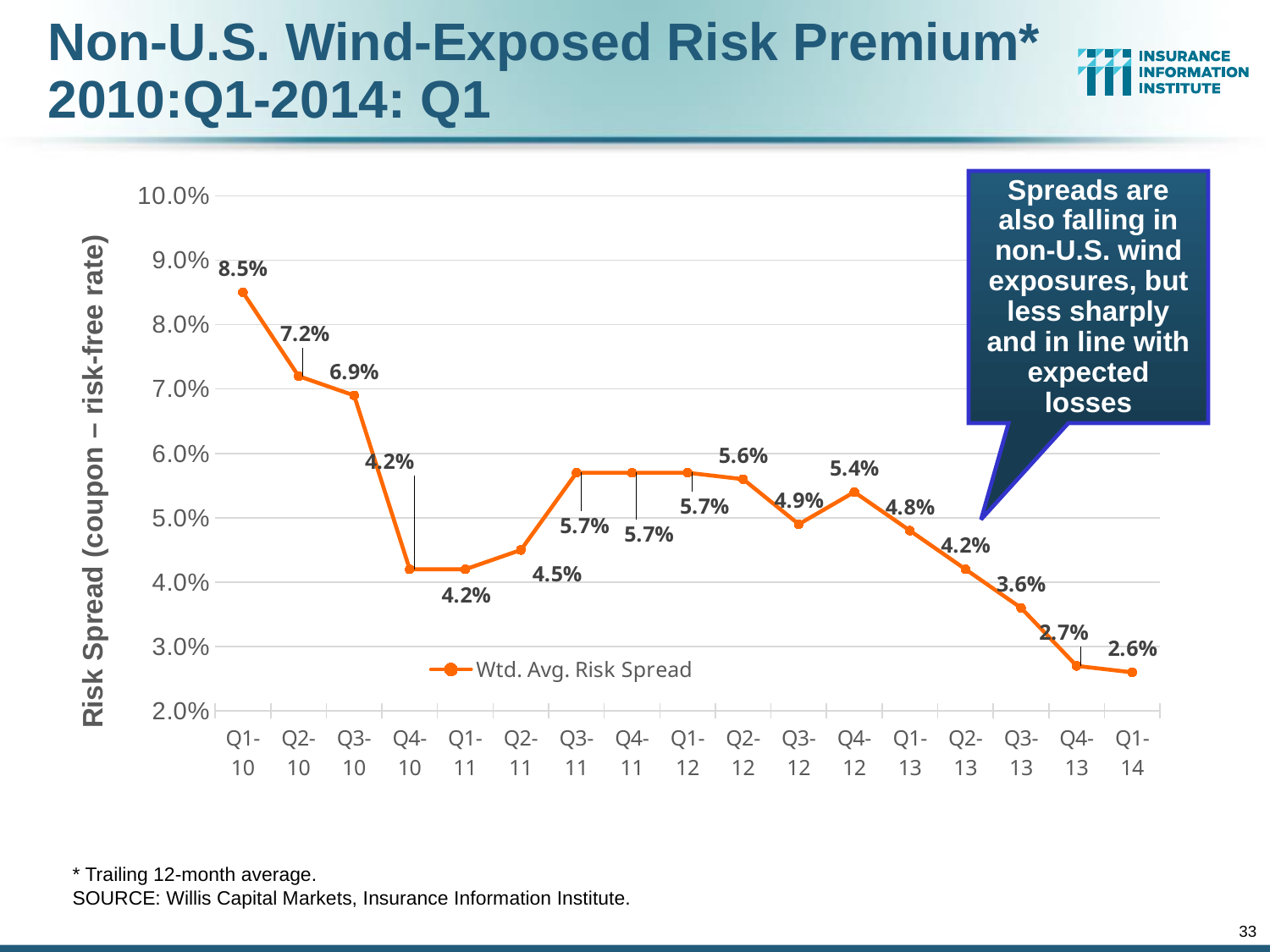
Which is larger, the risk spread in Q3-12 or in Q4-12? Q4-12 What is the difference between the risk spread in Q1-10 and Q1-14? 5.9% What is the weighted average risk spread for Q4-12? 5.4% What is the weighted average risk spread for Q1-10? 8.5% How many quarters are plotted on the x axis? 17 What kind of chart is shown on the slide? Line chart Is the value for Q3-10 greater or less than 6.0%? greater What is the weighted average risk spread for Q1-14? 2.6% Which quarter has the lowest weighted average risk spread? Q1-14 Does the risk spread rise or fall from Q4-12 to Q1-14? Fall Which quarter has the highest weighted average risk spread? Q1-10 How many series does the legend list? 1